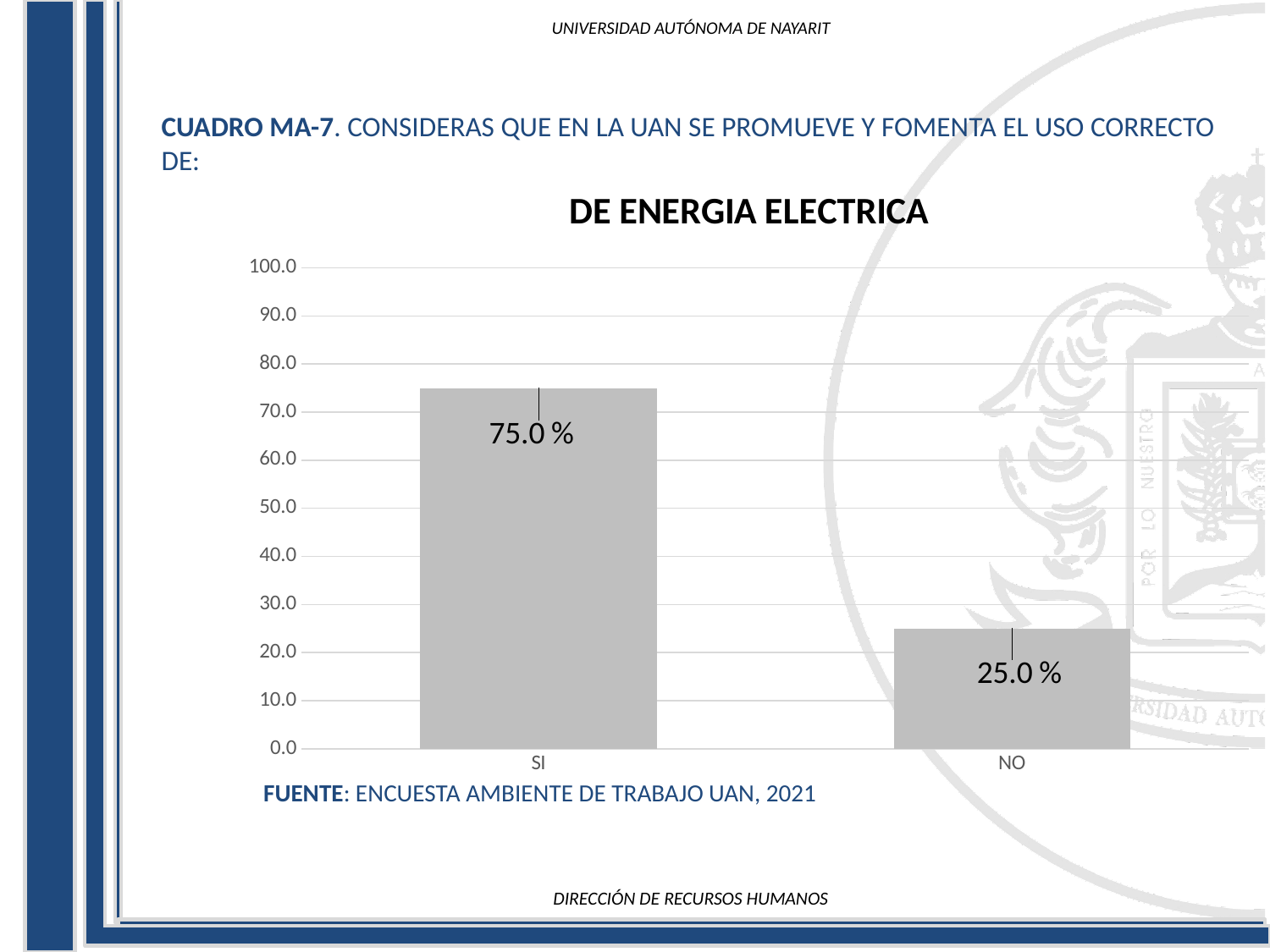
What is the difference between the values for SI and NO? 50.0 % What is the title of the chart? DE ENERGIA ELECTRICA Is the value for SI greater or less than 70.0? greater Which category has the lowest value? NO Which is larger, the value for SI or the value for NO? SI How many categories are shown on the x axis? 2 Which category has the highest value? SI What is the highest value shown on the y axis? 100.0 What kind of chart is shown? bar chart What is the value for SI? 75.0 % Is the value for NO greater or less than 30.0? less What is the value for NO? 25.0 %